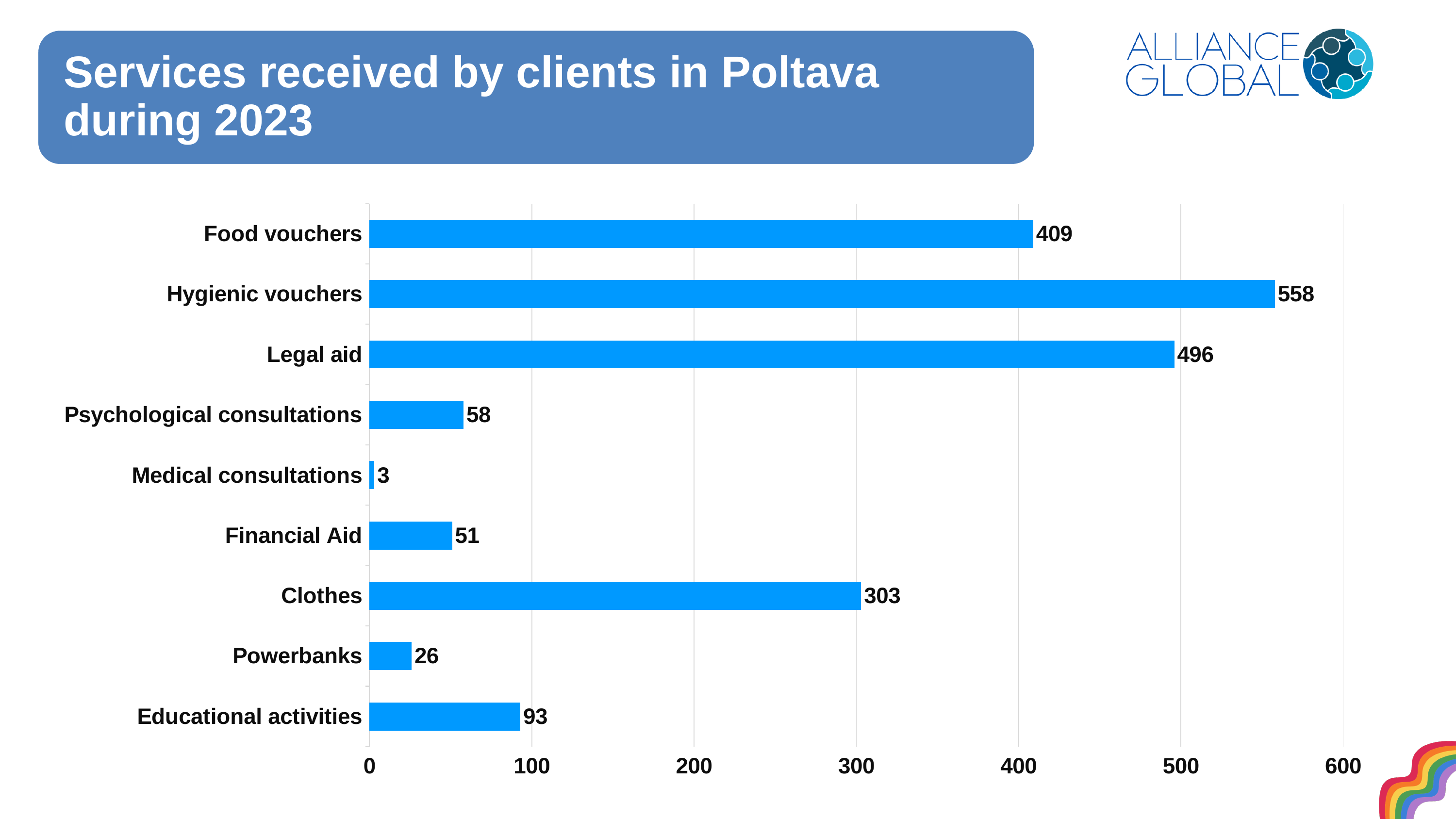
What is the value for Hygienic vouchers? 558 What is the value for Clothes? 303 What is the difference between Hygienic vouchers and Legal aid? 62 Which is larger, Psychological consultations or Financial Aid? Psychological consultations What is the difference between Food vouchers and Clothes? 106 What is the title of the slide? Services received by clients in Poltava during 2023 Which service has the lowest value? Medical consultations Is the value for Educational activities greater or less than 100? less What kind of chart is shown on the slide? bar chart How many service categories are shown in the chart? 9 Which service has the highest value? Hygienic vouchers What is the value for Medical consultations? 3